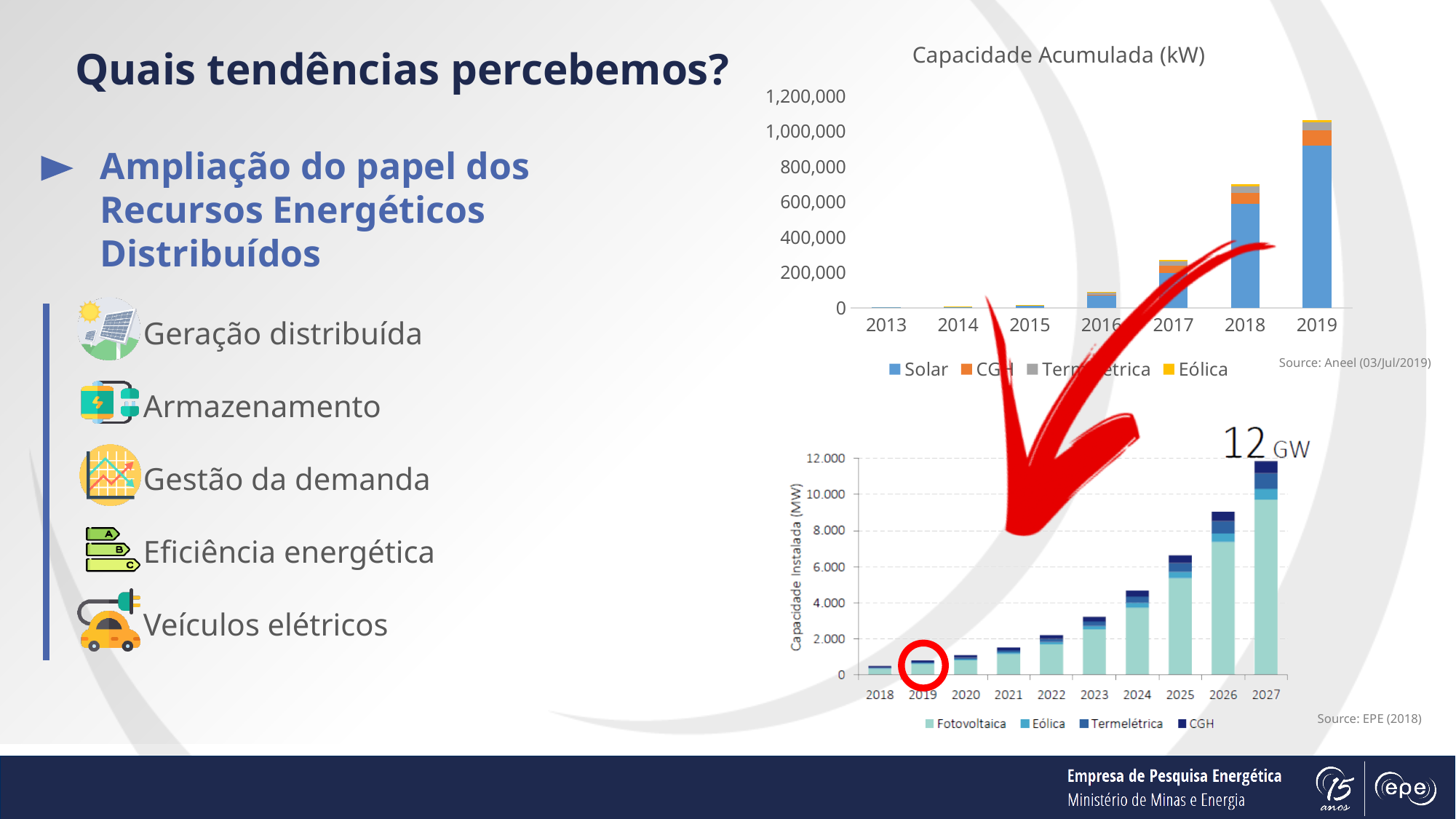
In the bottom chart (Capacidade Instalada (MW)), what total capacity is labelled for 2027? 12 GW What type of chart is the top chart titled "Capacidade Acumulada (kW)"? stacked bar chart In the top chart "Capacidade Acumulada (kW)", which series accounts for the largest part of each bar? Solar In the top chart "Capacidade Acumulada (kW)", how many years are shown on the x axis? 7 In the top chart "Capacidade Acumulada (kW)", how many series does the legend list? 4 In the top chart "Capacidade Acumulada (kW)", is the total for 2019 greater or less than 1,000,000? greater In the top chart "Capacidade Acumulada (kW)", is the total for 2016 greater or less than 200,000? less In the bottom chart (Capacidade Instalada (MW)), how many years are shown on the x axis? 10 In the top chart "Capacidade Acumulada (kW)", is the total for 2018 greater or less than 800,000? less In the top chart "Capacidade Acumulada (kW)", which year has the highest total capacity? 2019 In the bottom chart (Capacidade Instalada (MW)), do the totals rise or fall from 2018 to 2027? rise